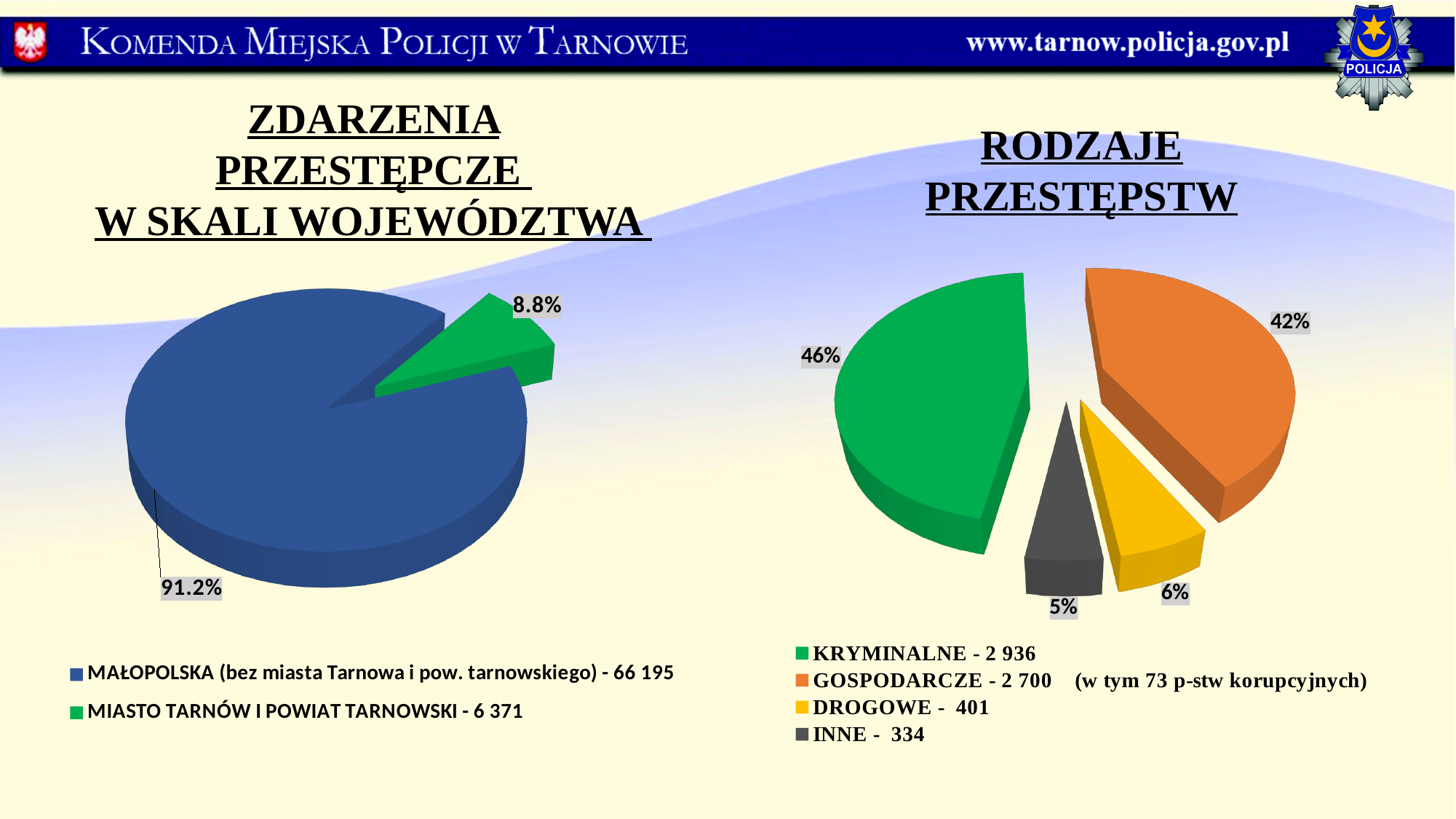
In the chart titled 'ZDARZENIA PRZESTĘPCZE W SKALI WOJEWÓDZTWA', what percentage share is shown for MIASTO TARNÓW I POWIAT TARNOWSKI? 8.8% In the chart titled 'RODZAJE PRZESTĘPSTW', which category has the largest share? KRYMINALNE What kind of chart is the one titled 'ZDARZENIA PRZESTĘPCZE W SKALI WOJEWÓDZTWA'? pie chart In the chart titled 'ZDARZENIA PRZESTĘPCZE W SKALI WOJEWÓDZTWA', what number is given in the legend for MAŁOPOLSKA (bez miasta Tarnowa i pow. tarnowskiego)? 66 195 In the chart titled 'RODZAJE PRZESTĘPSTW', what number is given in the legend for INNE? 334 In the chart titled 'RODZAJE PRZESTĘPSTW', what percentage share is shown for KRYMINALNE? 46% In the chart titled 'RODZAJE PRZESTĘPSTW', which category has the smallest share? INNE In the chart titled 'ZDARZENIA PRZESTĘPCZE W SKALI WOJEWÓDZTWA', what number is given in the legend for MIASTO TARNÓW I POWIAT TARNOWSKI? 6 371 In the chart titled 'RODZAJE PRZESTĘPSTW', what number is given in the legend for GOSPODARCZE? 2 700 How many categories does the legend of the chart titled 'RODZAJE PRZESTĘPSTW' list? 4 In the chart titled 'RODZAJE PRZESTĘPSTW', what percentage share is shown for DROGOWE? 6%